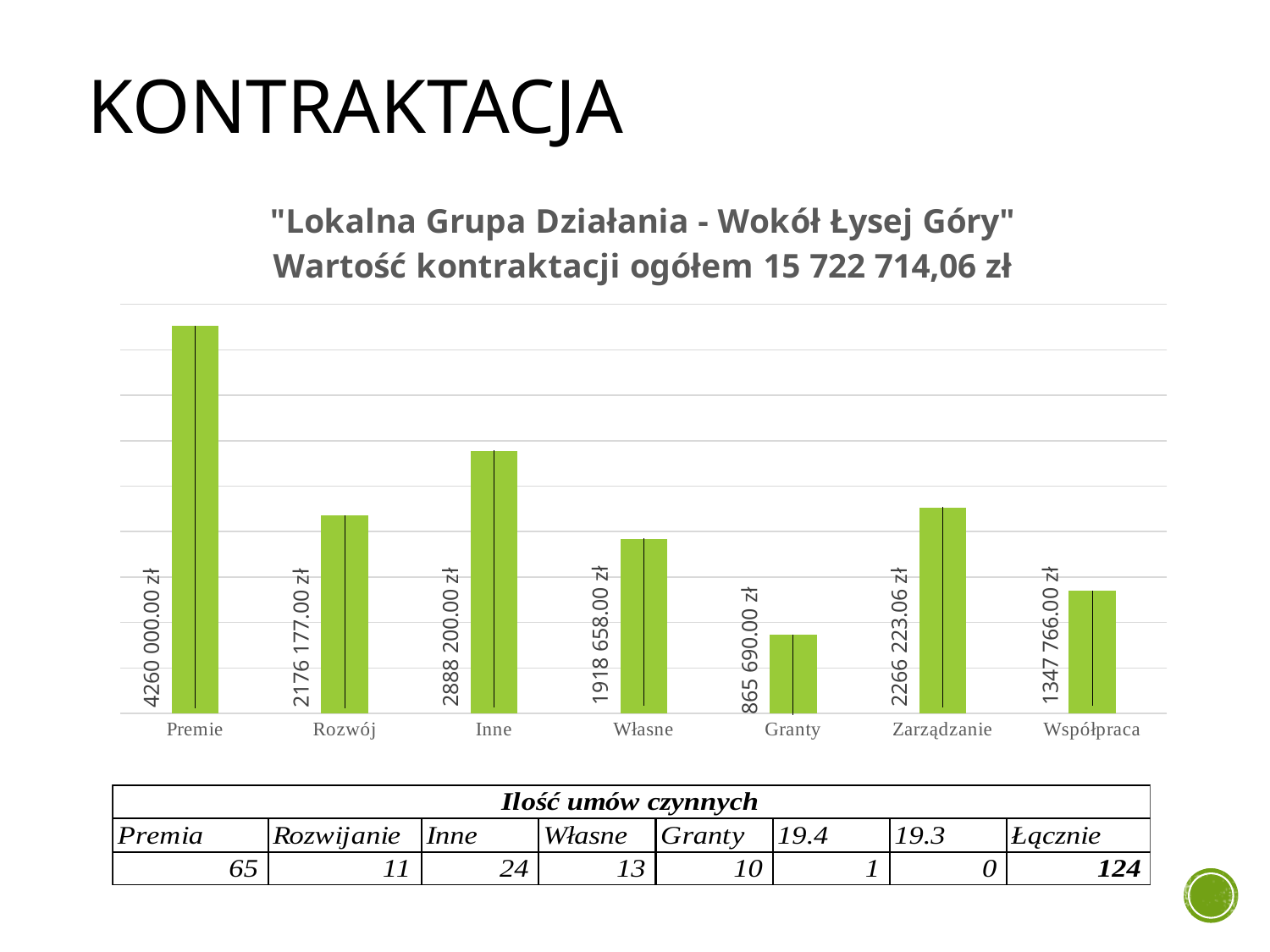
What is the difference between the values for Własne and Granty? 1052 968.00 zł What kind of chart is shown on the slide? Bar chart What is the difference between the values for Premie and Inne? 1371 800.00 zł What is the value for Premie? 4260 000.00 zł What is the value for Zarządzanie? 2266 223.06 zł What is the value for Granty? 865 690.00 zł What is the value for Współpraca? 1347 766.00 zł How many categories are shown in the chart? 7 What total contract value is stated in the chart title? 15 722 714,06 zł Which category has the lowest value? Granty Which is larger, the value for Inne or the value for Rozwój? Inne Which category has the highest value? Premie